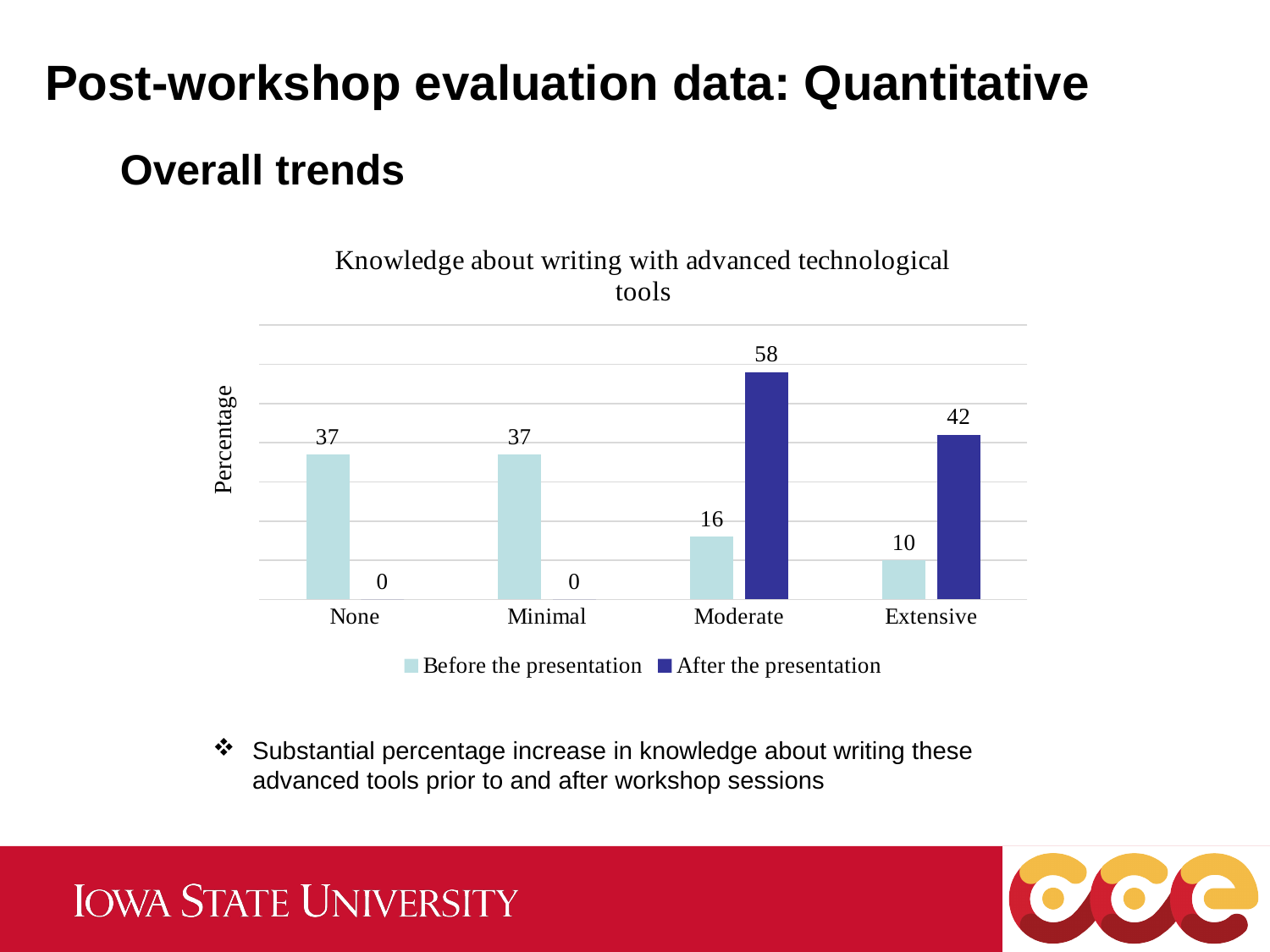
How many categories are shown on the x axis? 4 How many series does the legend list? 2 Which category has the lowest value for "Before the presentation"? Extensive Do the "After the presentation" values rise or fall from None to Moderate? Rise What kind of chart is shown on the slide? Bar chart Which category has the highest value for "After the presentation"? Moderate What is the value for "Before the presentation" in the Moderate category? 16 Which is larger in the Extensive category: "Before the presentation" or "After the presentation"? After the presentation What is the value for "After the presentation" in the Extensive category? 42 What is the value for "After the presentation" in the None category? 0 What is the difference between the "After the presentation" and "Before the presentation" values in the Moderate category? 42 What is the title of the chart? Knowledge about writing with advanced technological tools